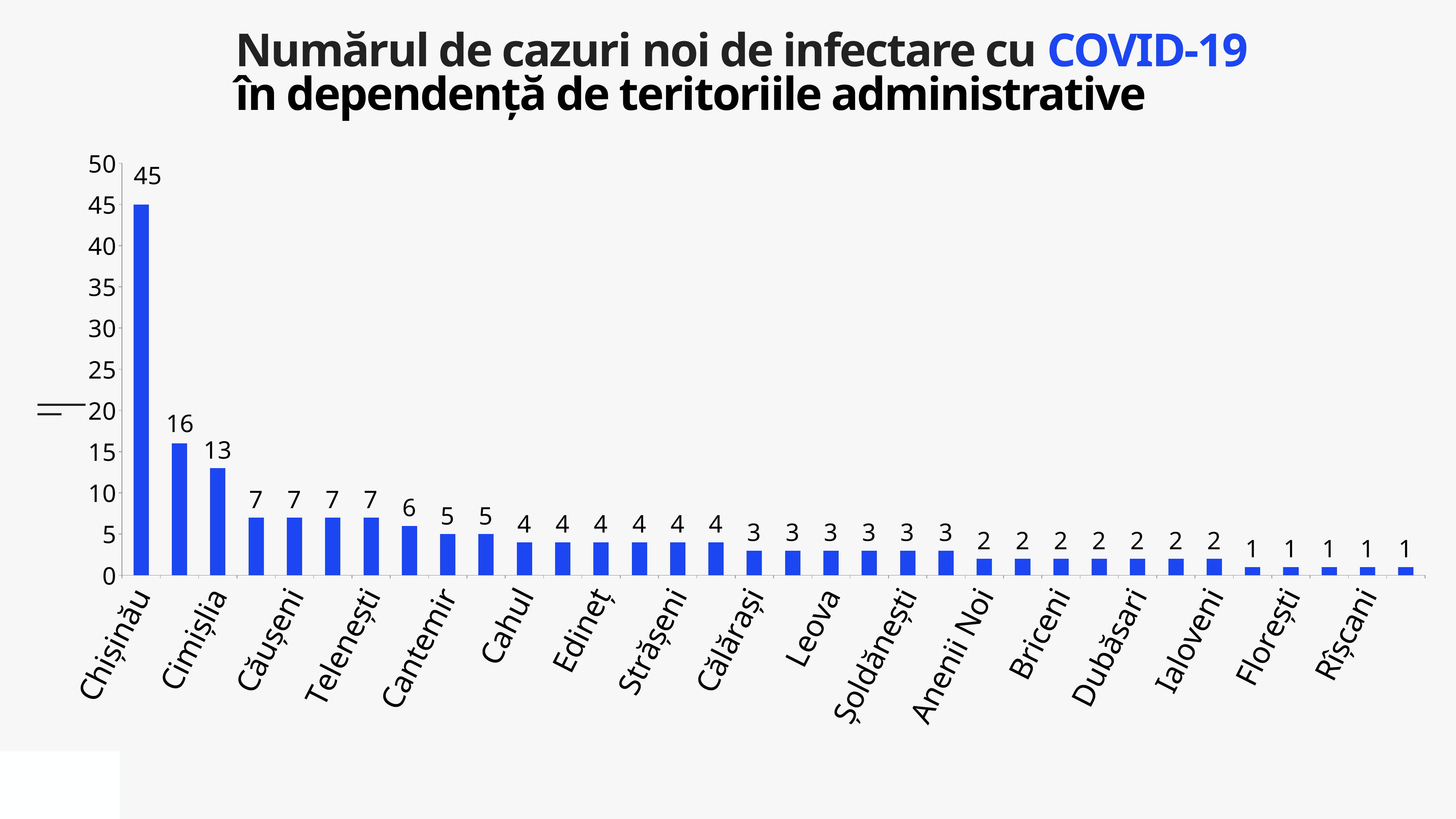
What is the value for Chișinău? 45 What is the value for Cimișlia? 13 What is the highest tick value shown on the vertical axis? 50 What is the difference between the values for Chișinău and Cimișlia? 32 What is the value for Rîșcani? 1 Do the values rise or fall from left to right along the x axis? fall Which is larger, the value for Căușeni or the value for Cahul? Căușeni How many bars are plotted in the chart? 34 Is the value for Chișinău greater or less than 40? greater Which territory has the highest number of new cases? Chișinău What is the value for Cantemir? 5 What kind of chart is shown on the slide? bar chart